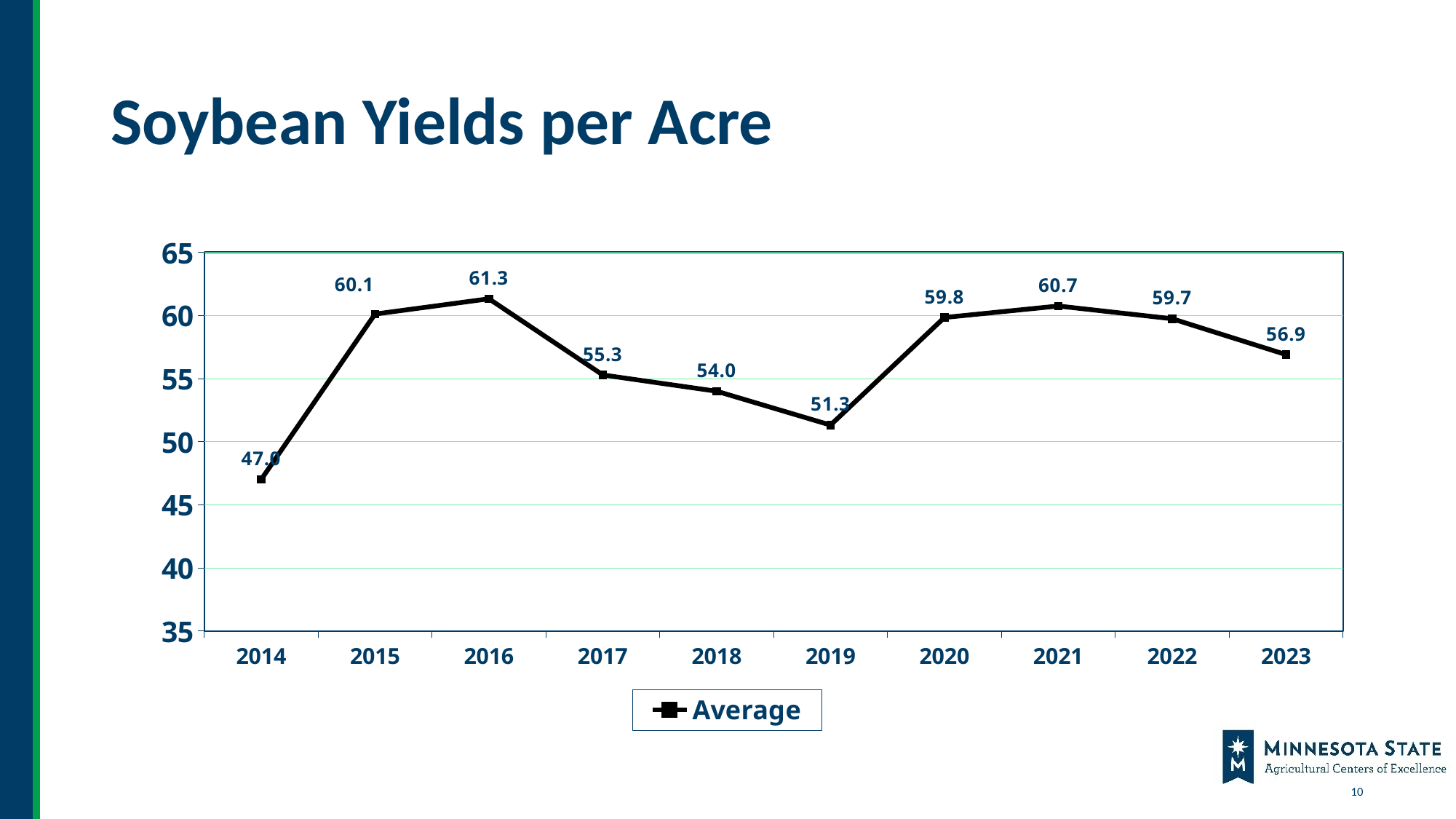
What is the average soybean yield per acre for 2023? 56.9 What is the title of the chart on the slide? Soybean Yields per Acre Which year has the highest average soybean yield per acre? 2016 What is the average soybean yield per acre for 2019? 51.3 How many series does the legend list? 1 What is the average soybean yield per acre for 2016? 61.3 How many years are plotted on the chart? 10 What kind of chart is shown on the slide? line chart Is the value for 2018 greater or less than 55? less Which year has a higher average soybean yield, 2017 or 2020? 2020 What is the difference between the 2016 and 2019 average soybean yields? 10.0 Which year has the lowest average soybean yield per acre? 2014